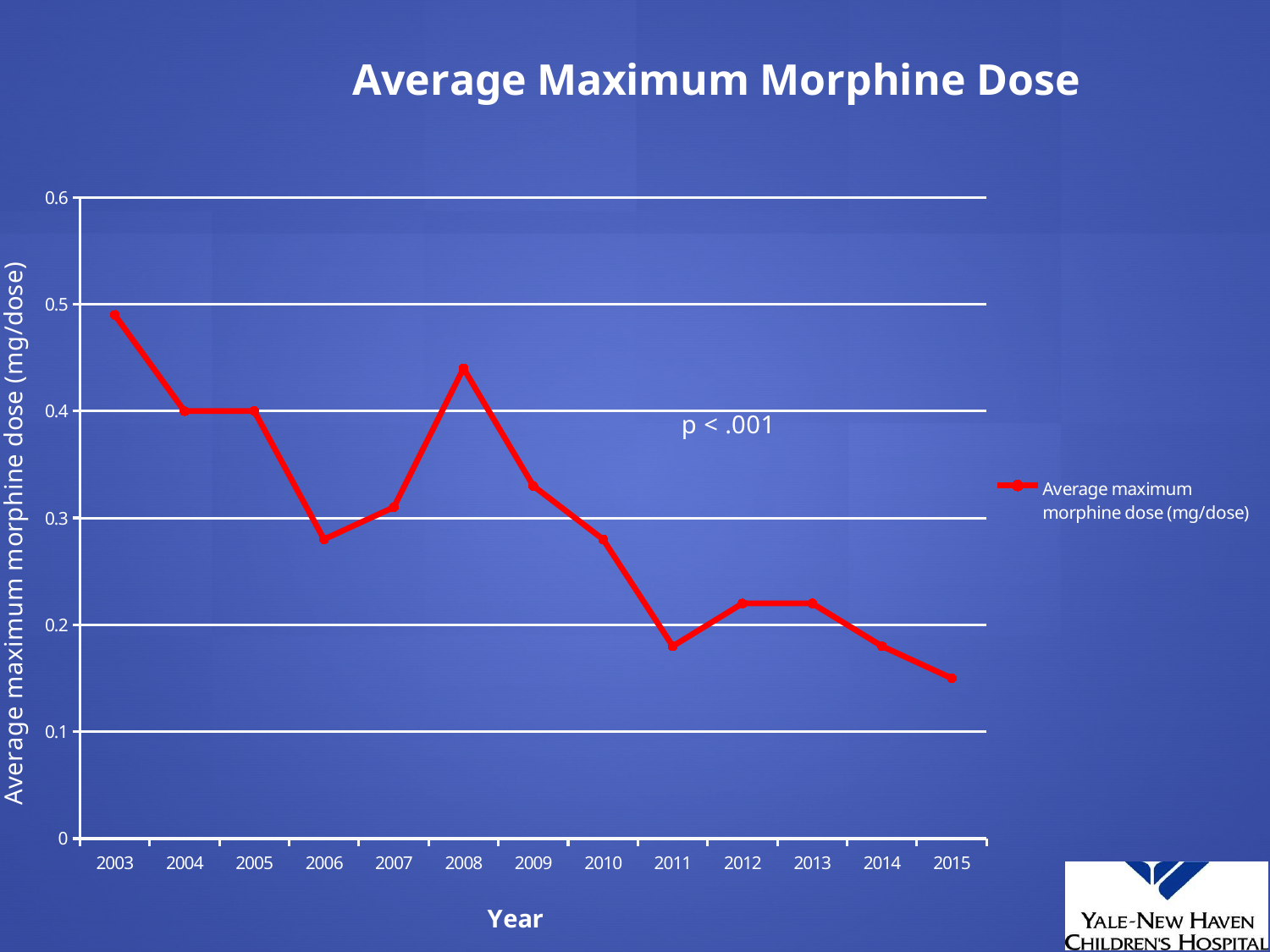
Which year has the lowest average maximum morphine dose? 2015 How many series does the legend list? 1 What is the title of the chart? Average Maximum Morphine Dose What kind of chart is shown on the slide? line chart Which year has the larger value, 2008 or 2010? 2008 Is the value for 2008 greater or less than 0.4? greater What is the average maximum morphine dose for 2004? 0.4 Is the value for 2015 greater or less than 0.2? less Which year has the highest average maximum morphine dose? 2003 How many years are plotted on the x axis? 13 Overall, do the values rise or fall from 2003 to 2015? fall Is the value for 2006 greater or less than 0.3? less